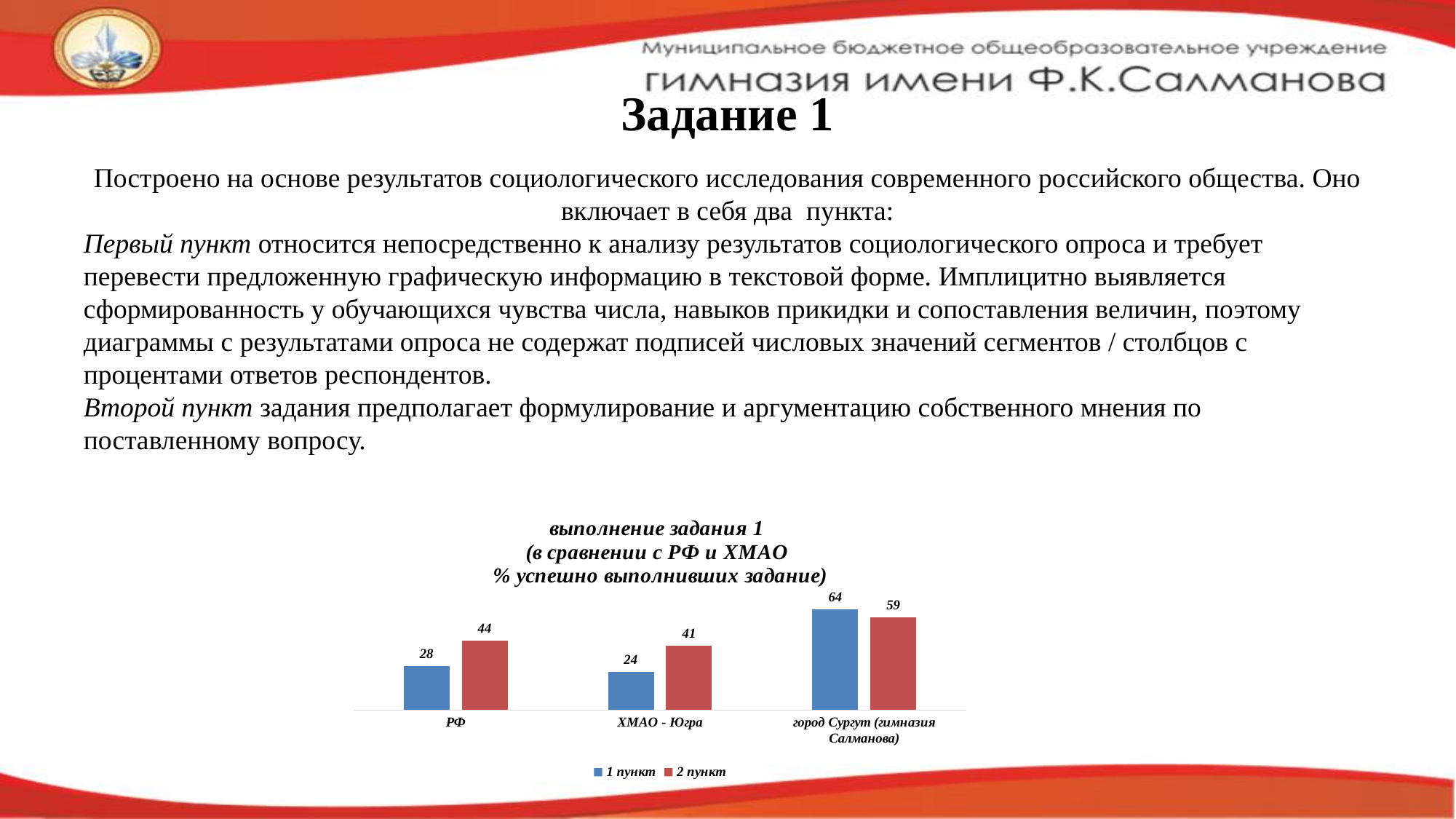
What is the value for '2 пункт' for ХМАО - Югра? 41 How many categories are shown on the x axis? 3 How many series does the legend list? 2 Which is larger for город Сургут (гимназия Салманова): '1 пункт' or '2 пункт'? 1 пункт What is the difference between the '2 пункт' and '1 пункт' values for РФ? 16 What kind of chart is shown on the slide? bar chart Which category has the highest value for '2 пункт'? город Сургут (гимназия Салманова) Which category has the lowest value for '1 пункт'? ХМАО - Югра What is the value for '1 пункт' for город Сургут (гимназия Салманова)? 64 What is the difference between the '1 пункт' values for город Сургут (гимназия Салманова) and ХМАО - Югра? 40 What is the value for '1 пункт' for РФ? 28 What colour are the bars for '2 пункт'? red